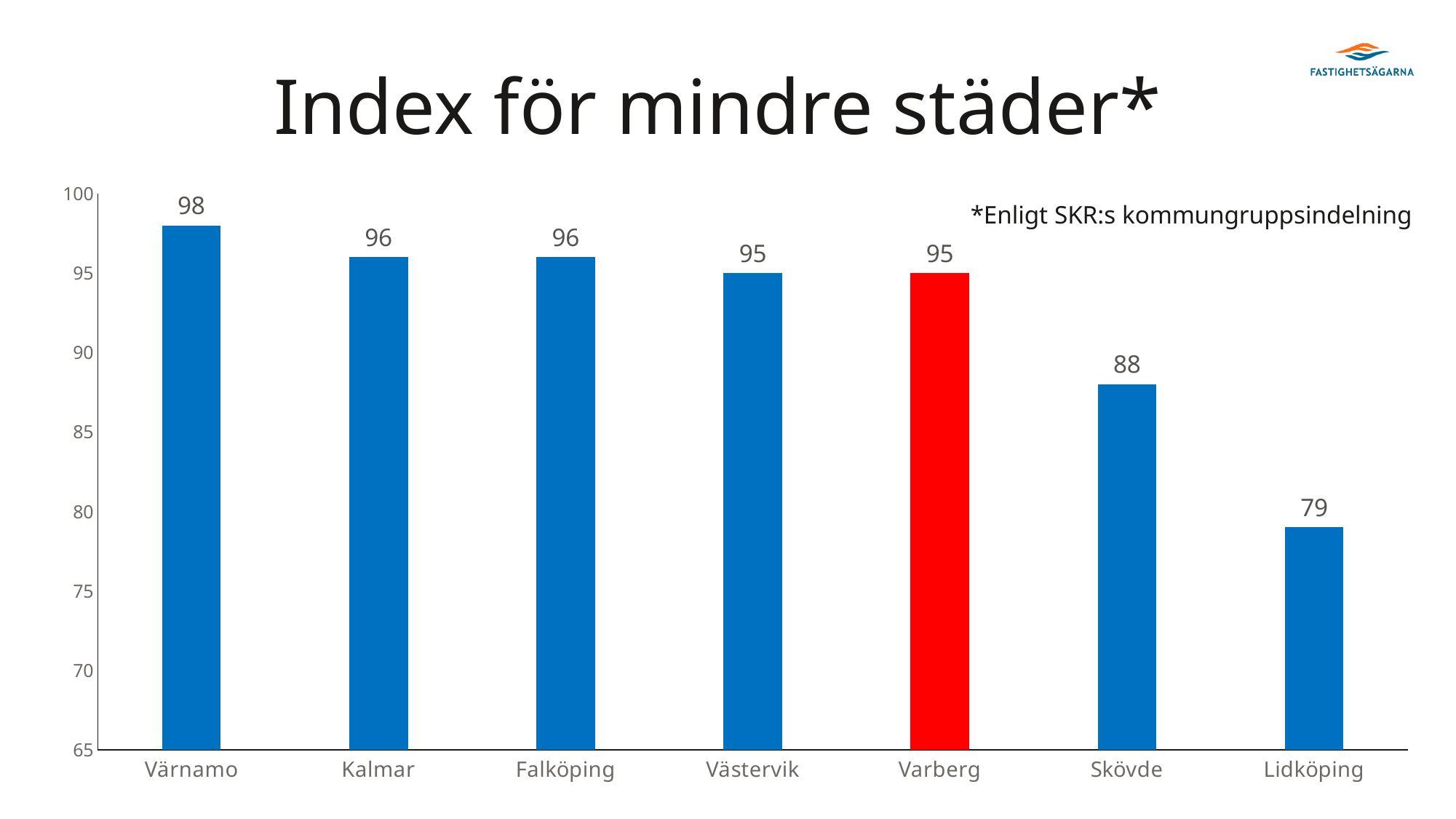
What is the index value for Skövde? 88 Do the values rise or fall from left to right across the chart? Fall What is the difference between the index values for Värnamo and Lidköping? 19 What is the index value for Varberg? 95 What is the index value for Värnamo? 98 Which city's bar is coloured red? Varberg Which city has the lowest index value? Lidköping How many cities are shown in the chart? 7 Which city has the highest index value? Värnamo What type of chart is shown on the slide? Bar chart Which has a higher index value, Västervik or Skövde? Västervik What is the difference between the index values for Kalmar and Skövde? 8